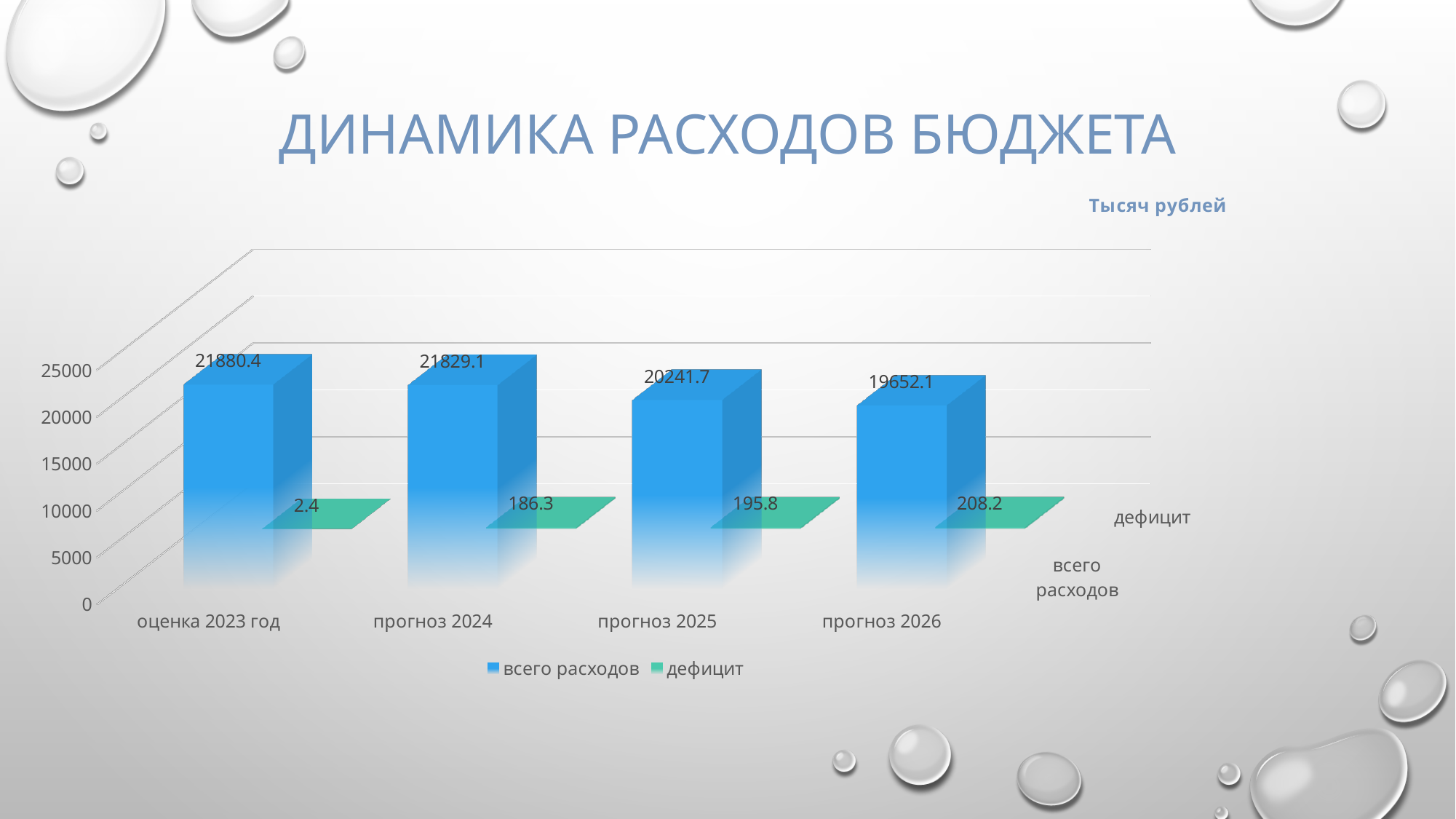
Which category has the highest value for дефицит? прогноз 2026 How many series does the legend list? 2 What is the value of всего расходов for оценка 2023 год? 21880.4 How many categories are shown on the x axis? 4 What kind of chart is shown on the slide? bar chart Which category has the lowest value for всего расходов? прогноз 2026 Do the values for всего расходов rise or fall from оценка 2023 год to прогноз 2026? fall Which is larger: всего расходов for прогноз 2024 or for прогноз 2025? прогноз 2024 What is the value of всего расходов for прогноз 2025? 20241.7 What is the value of дефицит for прогноз 2026? 208.2 What is the difference between всего расходов for оценка 2023 год and for прогноз 2026? 2228.3 What is the difference between дефицит for прогноз 2026 and for оценка 2023 год? 205.8